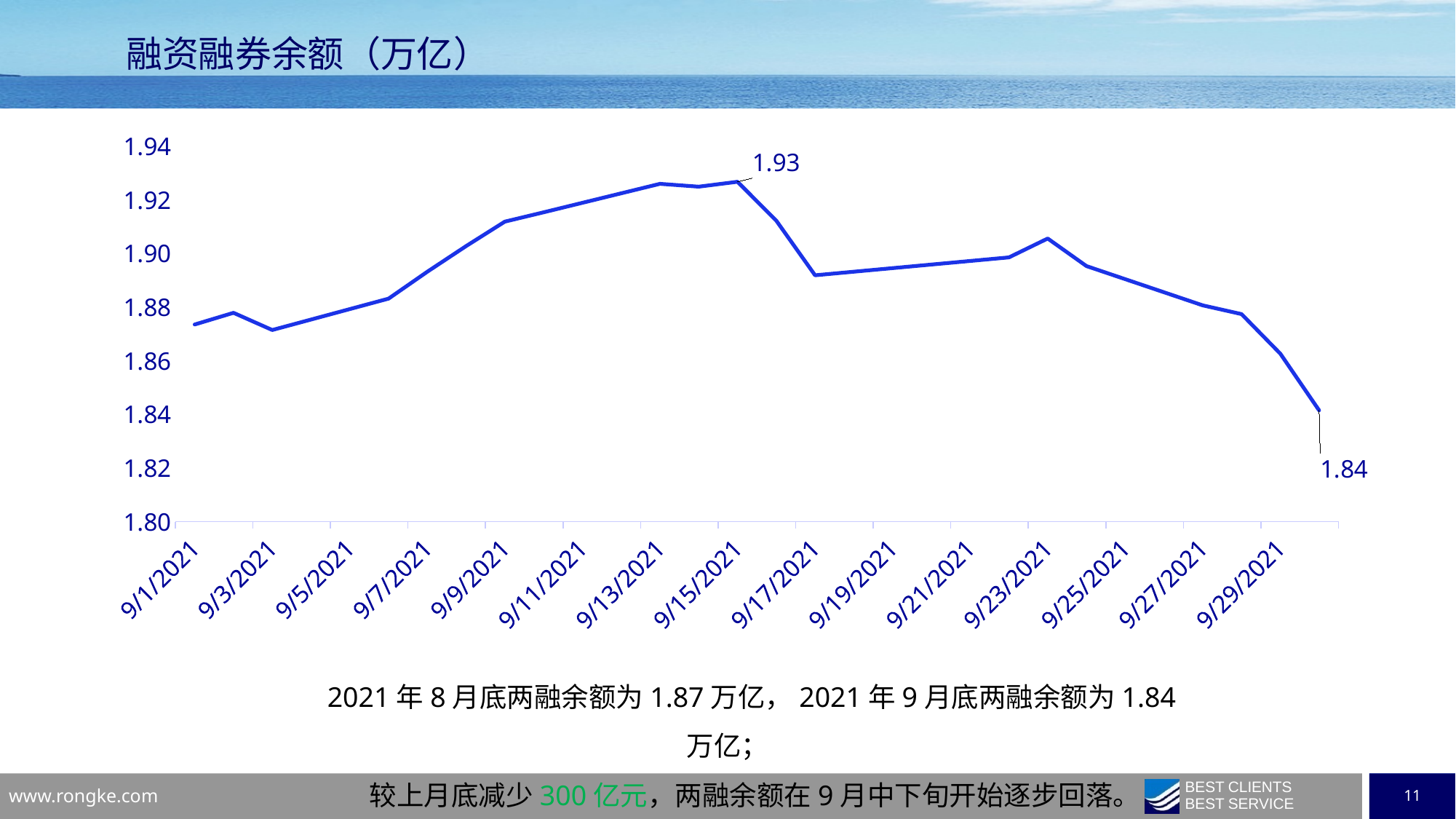
Does the line rise or fall from 9/23/2021 to the end of the series? fall Is the value for 9/29/2021 greater or less than 1.88? less What kind of chart is shown on the slide? line chart What is the lowest value labeled on the chart? 1.84 Is the value for 9/1/2021 greater or less than 1.86? greater What is the title of the chart? 融资融券余额（万亿） What is the difference between the labeled value at 9/15/2021 (1.93) and the labeled value at the end of the line (1.84)? 0.09 What value is labeled on the chart at 9/15/2021? 1.93 Which date has the larger value, 9/15/2021 or 9/17/2021? 9/15/2021 What value is labeled at the last point of the line (end of September 2021)? 1.84 Is the value for 9/17/2021 greater or less than 1.90? less How many date labels are shown on the x axis? 15